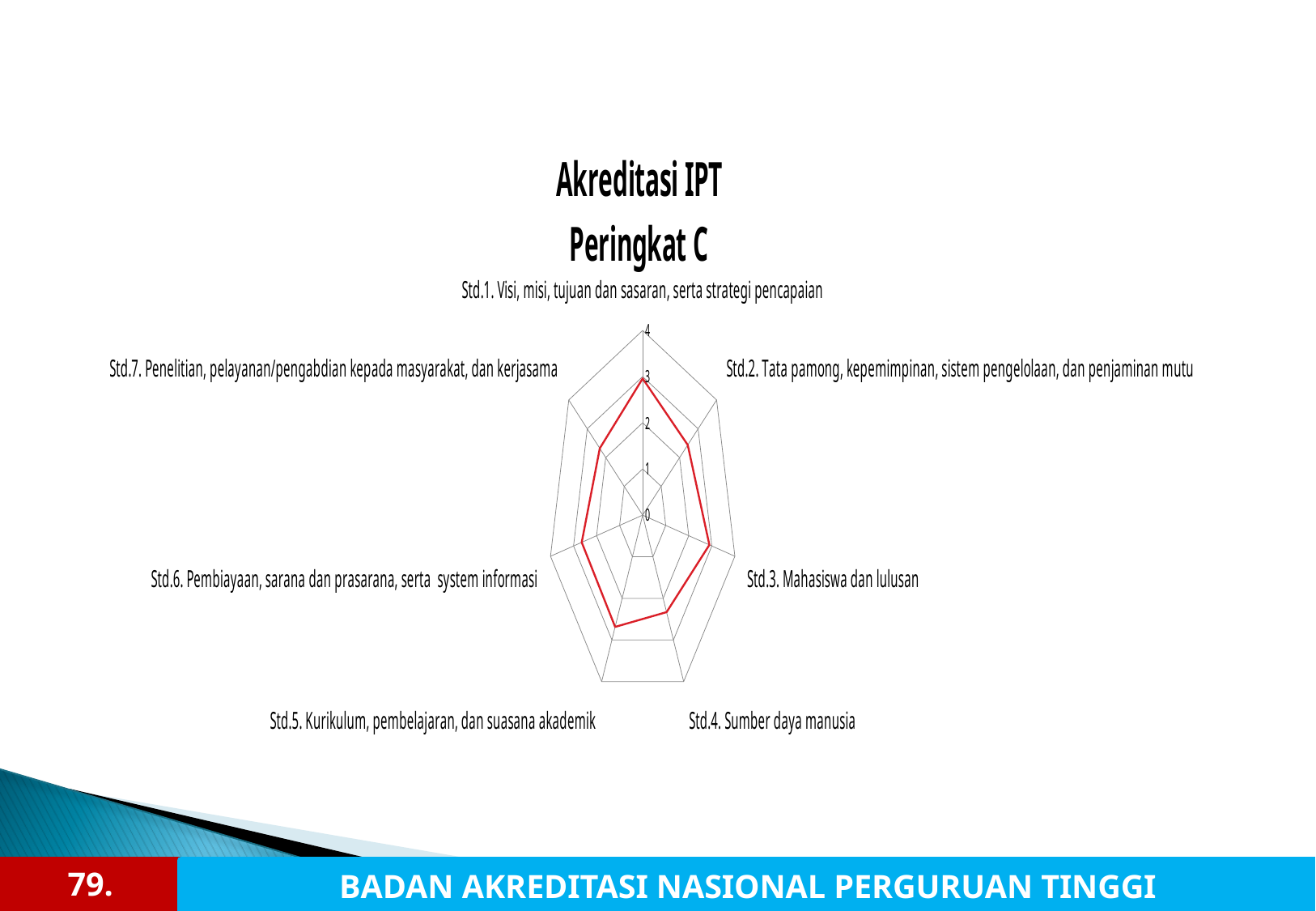
Is the value for Std.3 (Mahasiswa dan lulusan) greater or less than 2? greater What is the highest value shown on the radar chart's axis scale? 4 Which has the larger value, Std.1 or Std.2? Std.1 Is the value for Std.1 (Visi, misi, tujuan dan sasaran, serta strategi pencapaian) greater or less than 2? greater How many standards (categories) are plotted on the radar chart? 7 What kind of chart is shown on the slide? Radar chart Is the value for Std.6 (Pembiayaan, sarana dan prasarana, serta system informasi) greater or less than 3? less What is the title of the chart? Akreditasi IPT Peringkat C Which has the larger value, Std.3 or Std.7? Std.3